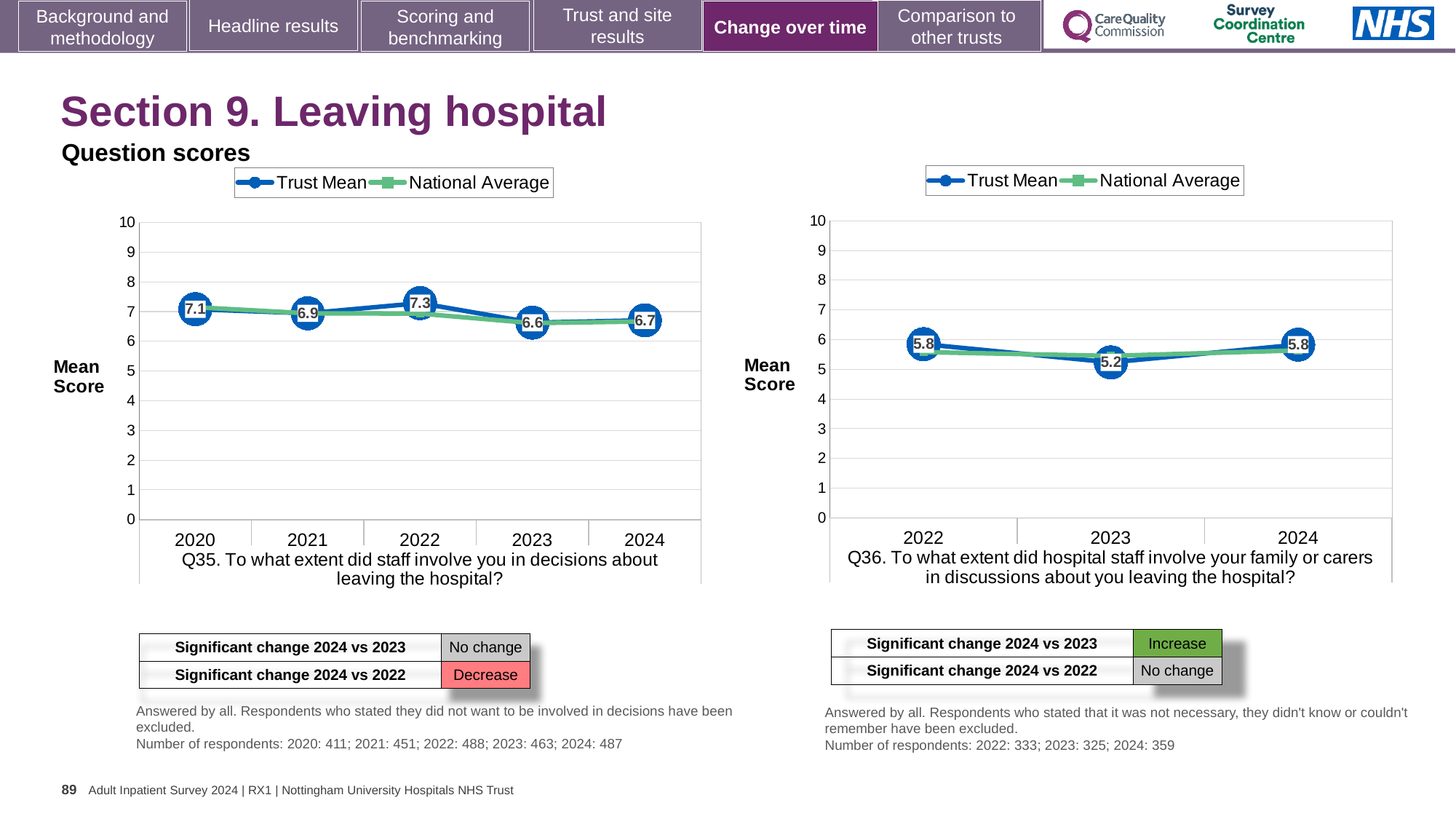
In the Q36 chart (right), which year has the lowest Trust Mean score? 2023 In the Q35 chart (left), what is the difference between the Trust Mean scores for 2022 and 2023? 0.7 In the Q35 chart (left), which year has the lowest Trust Mean score? 2023 In the Q35 chart (left), what is the Trust Mean score for 2024? 6.7 In the Q35 chart (left), what is the Trust Mean score for 2022? 7.3 In the Q35 chart (left), is the Trust Mean score higher in 2020 or in 2021? 2020 In the Q35 chart (left), which year has the highest Trust Mean score? 2022 In the Q36 chart (right), what is the Trust Mean score for 2023? 5.2 How many years are plotted on the x axis of the Q36 chart (right)? 3 How many series does the legend of the Q35 chart (left) list? 2 In the Q36 chart (right), what is the difference between the Trust Mean scores for 2024 and 2023? 0.6 In the Q36 chart (right), is the National Average value for 2023 greater or less than 7? less